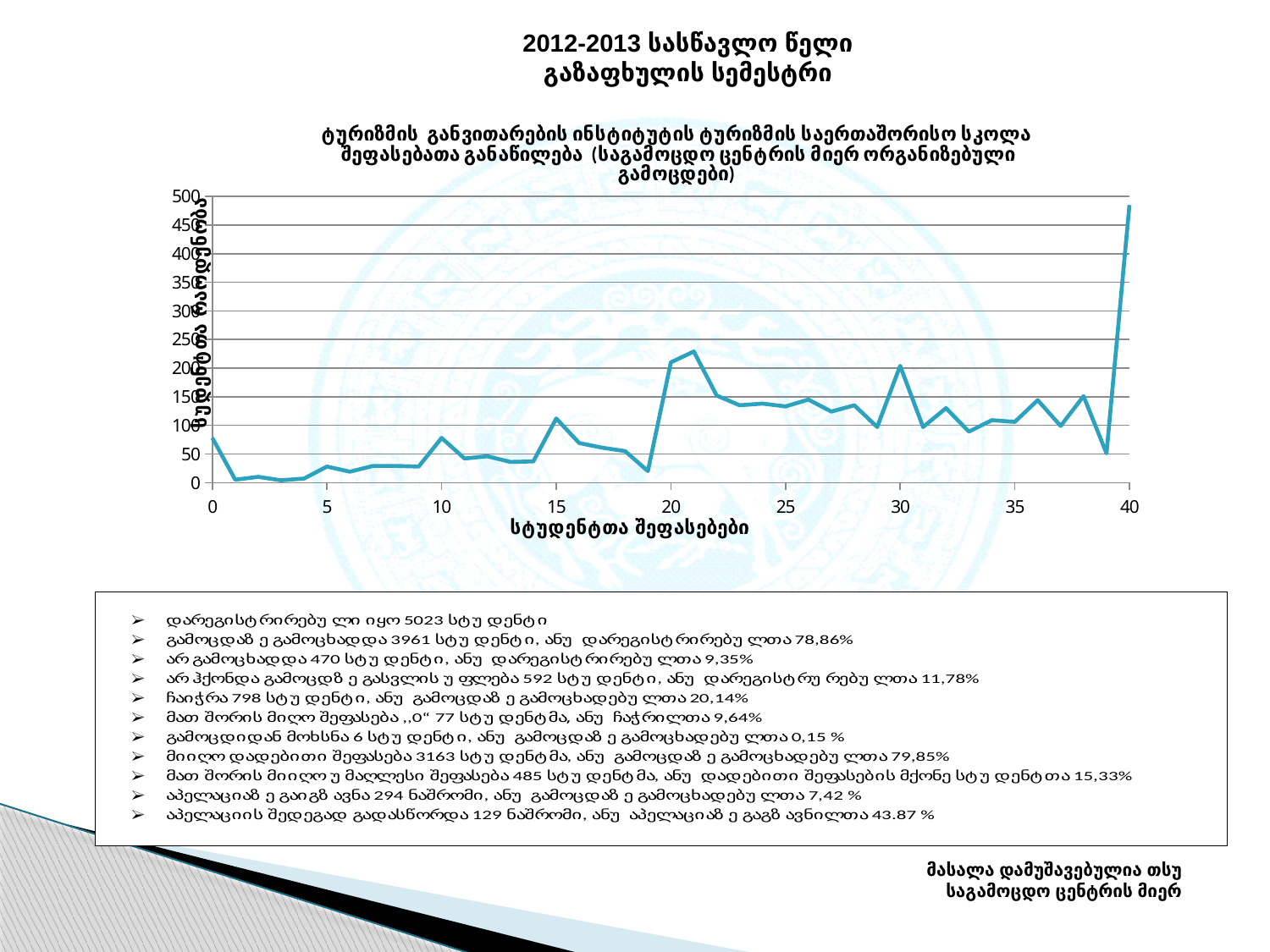
Is the value at x = 21 greater or less than 200? greater What kind of chart is shown on the slide? line chart What is the label of the x axis of the chart? სტუდენტთა შეფასებები Is the value at x = 3 greater or less than 50? less Which has the larger value, x = 21 or x = 10? x = 21 At which x-axis value does the line reach its highest point? 40 Is the value at x = 40 greater or less than 400? greater Which has the larger value, x = 30 or x = 29? x = 30 What is the highest value shown on the y axis of the chart? 500